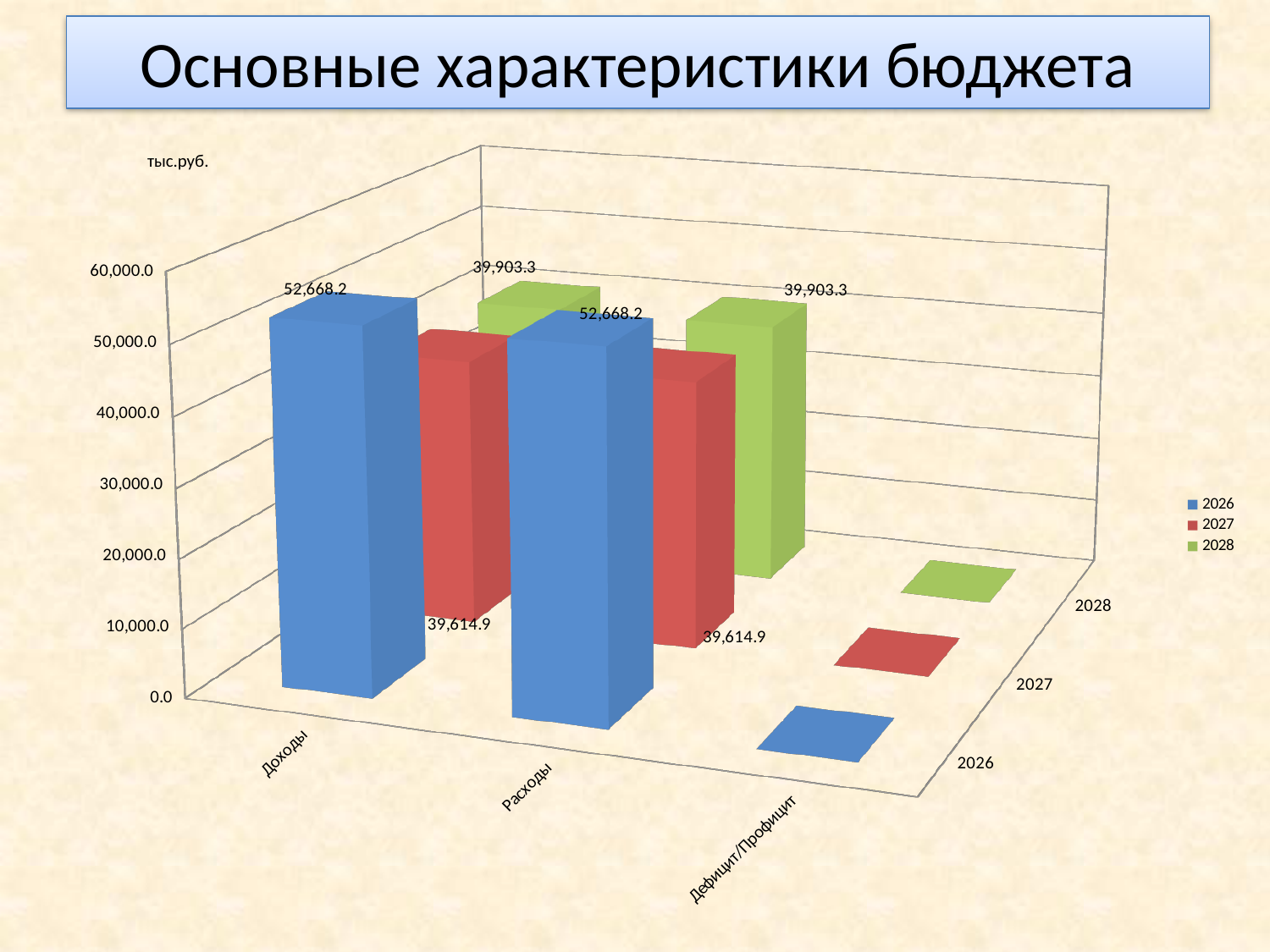
What unit is shown at the top of the vertical axis? тыс.руб. How many categories are shown on the x axis? 3 What is the value for Расходы in 2026? 52,668.2 What kind of chart is shown on the slide? Bar chart Which is larger: Расходы in 2026 or Расходы in 2028? Расходы in 2026 What is the value for Расходы in 2027? 39,614.9 What is the value for Доходы in 2026? 52,668.2 What is the value for Доходы in 2028? 39,903.3 What is the difference between the Доходы values for 2026 and 2027? 13,053.3 Which year has the lowest value for Расходы? 2027 Which year has the highest value for Доходы? 2026 How many series does the legend list? 3